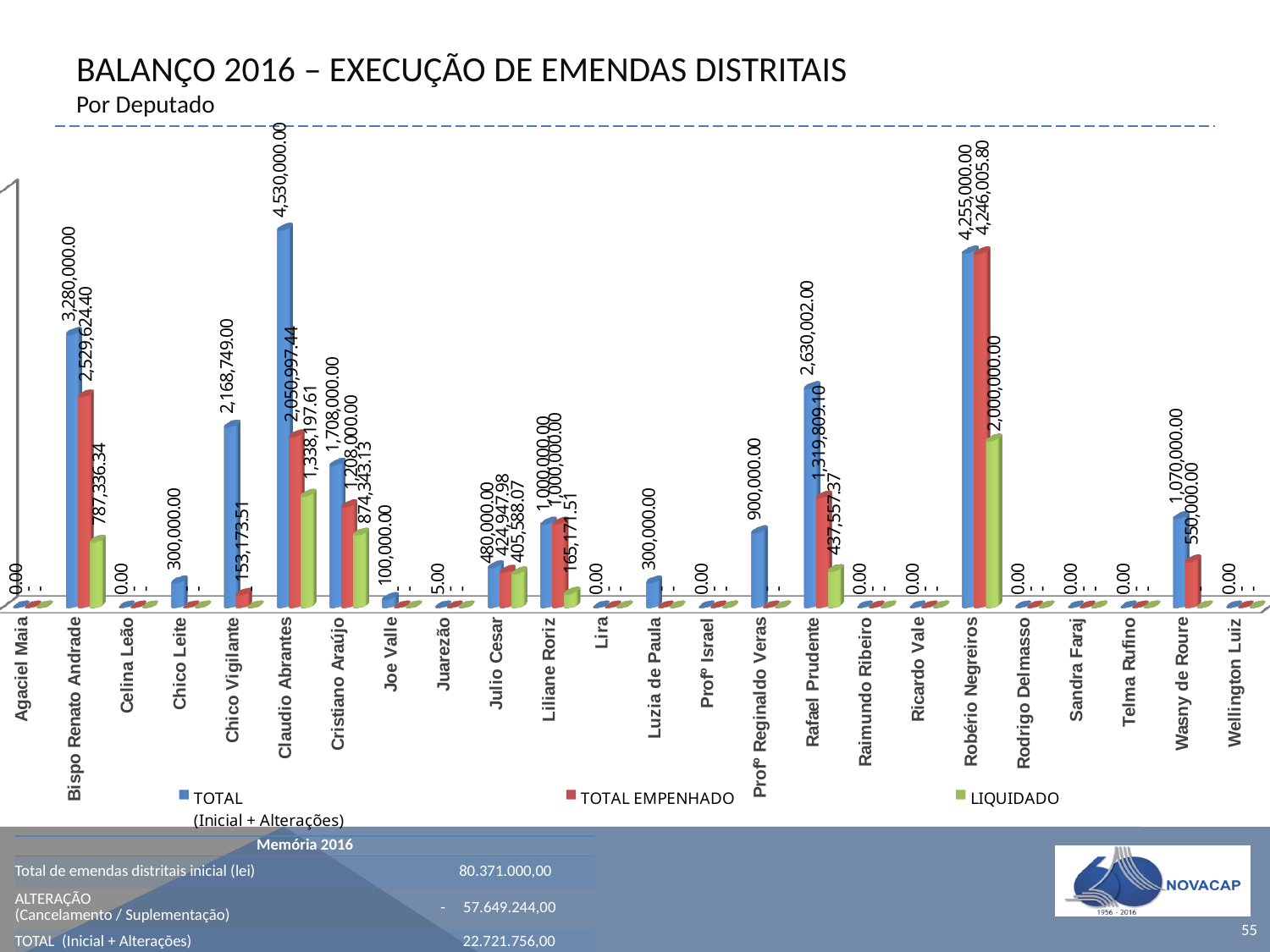
What kind of chart is shown on the slide? Bar chart Which is larger, the TOTAL (Inicial + Alterações) value for Rafael Prudente or for Chico Vigilante? Rafael Prudente How many deputies (categories) are shown on the x axis of the chart? 24 How many series does the chart legend list? 3 What is the LIQUIDADO value for Cristiano Araújo? 874,343.13 What is the difference between the TOTAL (Inicial + Alterações) values of Claudio Abrantes and Robério Negreiros? 275,000.00 What is the difference between the TOTAL (Inicial + Alterações) and TOTAL EMPENHADO values for Wasny de Roure? 520,000.00 What is the TOTAL (Inicial + Alterações) value for Claudio Abrantes? 4,530,000.00 Which deputy has the highest TOTAL (Inicial + Alterações) value? Claudio Abrantes What is the TOTAL EMPENHADO value for Bispo Renato Andrade? 2,529,624.40 Which deputy has the highest TOTAL EMPENHADO value? Robério Negreiros What is the LIQUIDADO value for Robério Negreiros? 2,000,000.00